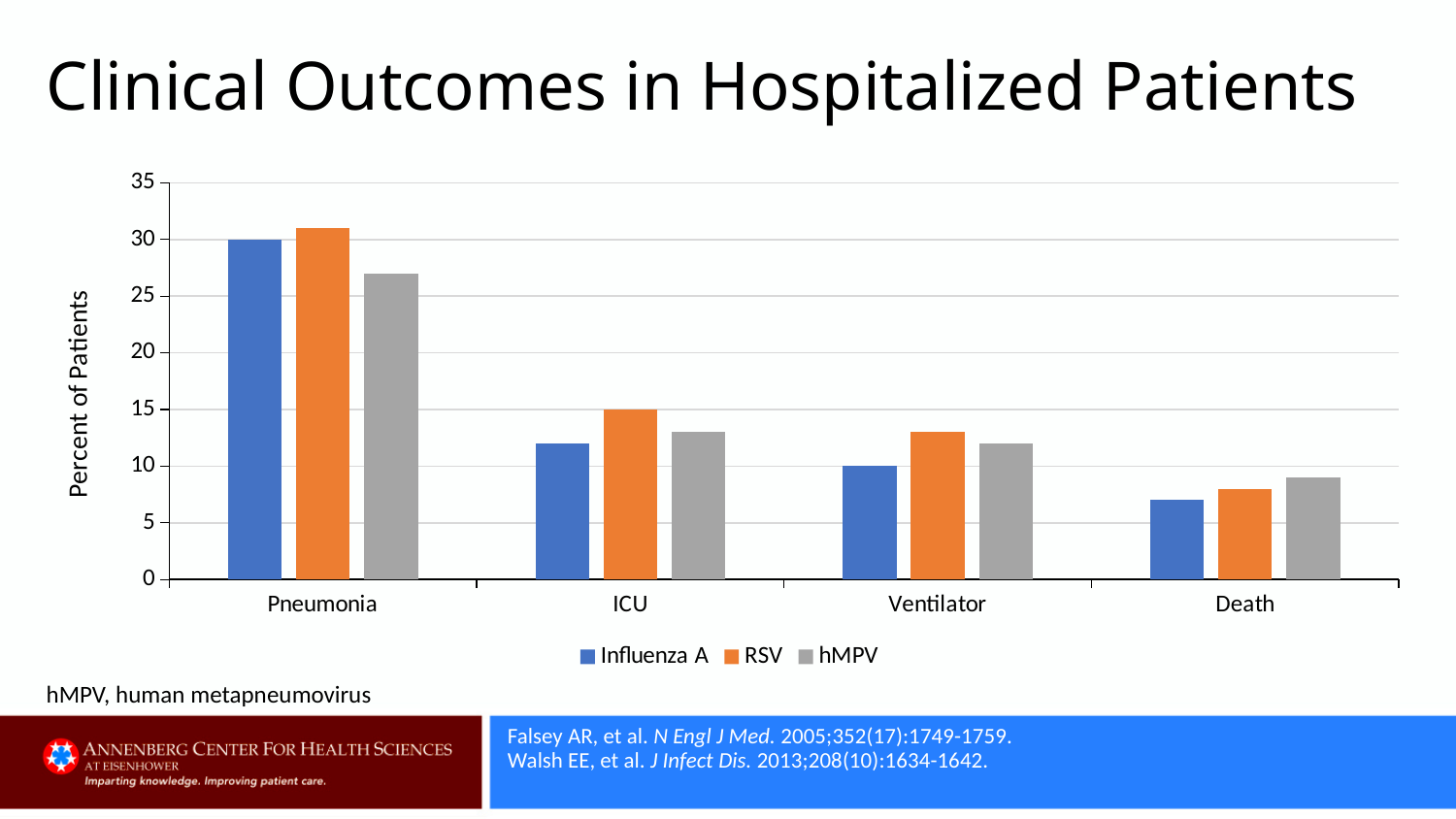
What kind of chart is shown on the slide? bar chart Which is larger for Influenza A: the Pneumonia value or the ICU value? Pneumonia Is the value for RSV in the Ventilator category greater or less than 10? greater How many series does the legend list? 3 Is the value for hMPV in the Death category greater or less than 10? less How many outcome categories are shown on the x axis? 4 What is the percent of patients with pneumonia for Influenza A? 30 Which outcome category has the lowest values across all three viruses? Death What is the percent of patients admitted to the ICU for RSV? 15 What is the label on the y axis? Percent of Patients Is the value for hMPV in the Pneumonia category greater or less than 30? less Which outcome category has the highest values across all three viruses? Pneumonia